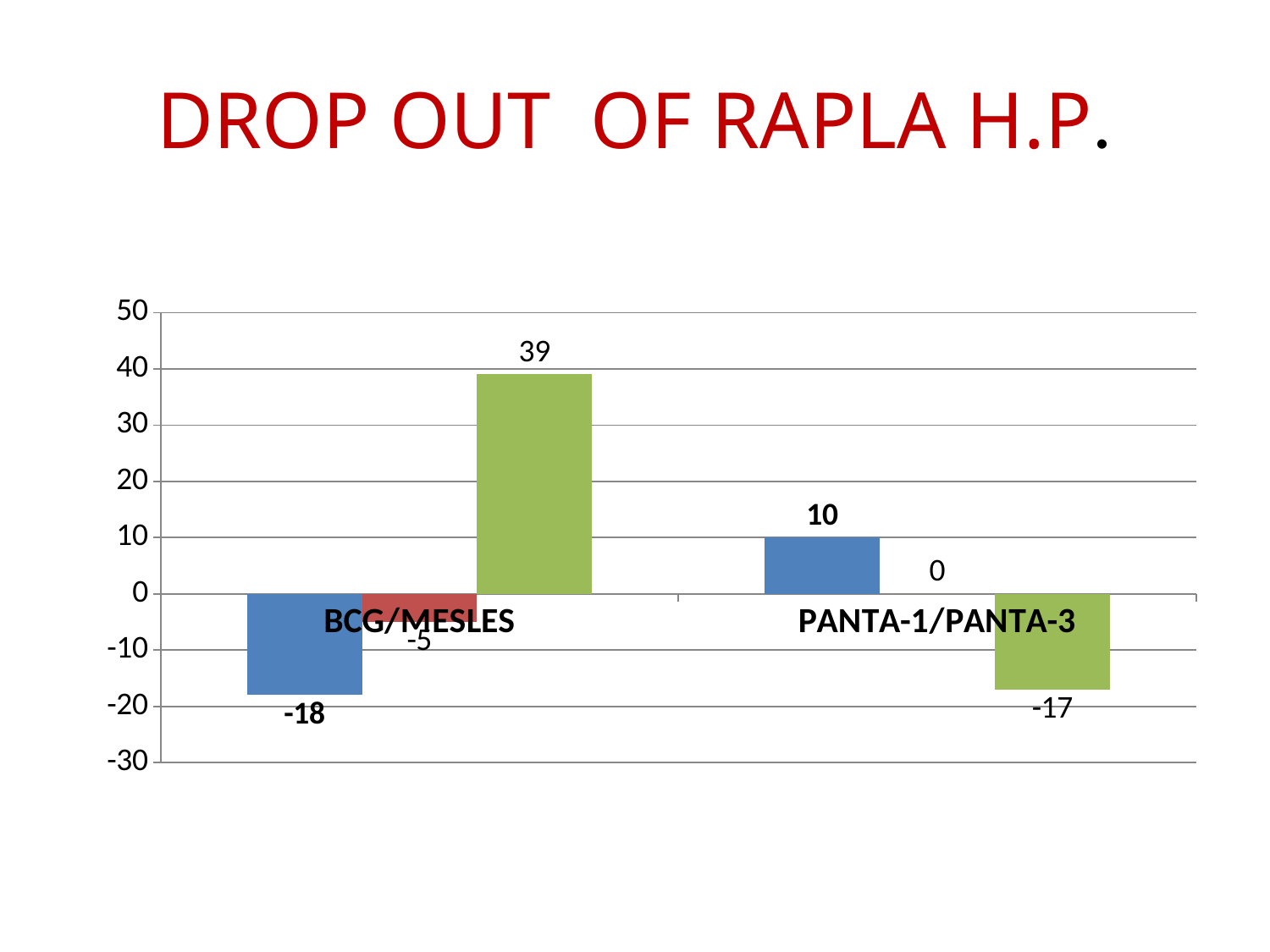
What is the value of the red bar for BCG/MESLES? -5 What is the value of the red bar for PANTA-1/PANTA-3? 0 What type of chart is shown on the slide? Bar chart Which bar has the lowest value on the chart? The blue bar for BCG/MESLES (-18) Which bar has the highest value on the chart? The green bar for BCG/MESLES (39) What is the value of the green bar for BCG/MESLES? 39 What is the value of the green bar for PANTA-1/PANTA-3? -17 How many categories are shown on the x axis? 2 Which is larger, the blue bar for BCG/MESLES or the blue bar for PANTA-1/PANTA-3? The blue bar for PANTA-1/PANTA-3 What is the value of the blue bar for PANTA-1/PANTA-3? 10 What is the value of the blue bar for BCG/MESLES? -18 What is the difference between the green bar for BCG/MESLES and the blue bar for PANTA-1/PANTA-3? 29